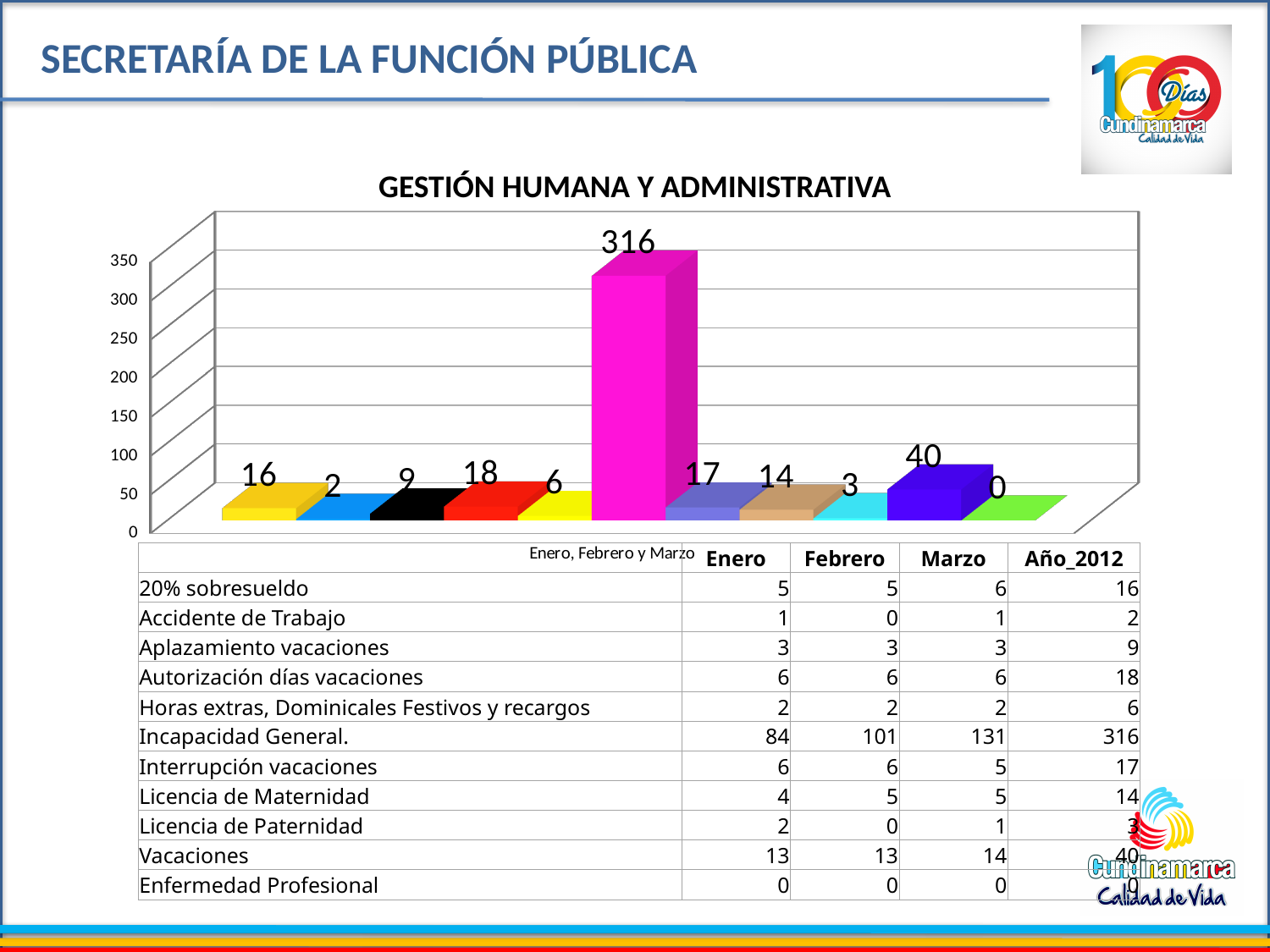
What is the title of the chart? GESTIÓN HUMANA Y ADMINISTRATIVA What is the value labelled on the bar for Vacaciones? 40 What kind of chart is shown on the slide? bar chart What is the value shown on the tallest bar in the chart? 316 Which is larger, the value for Vacaciones or the value for Interrupción vacaciones? Vacaciones Which category has the lowest value in the chart? Enfermedad Profesional What is the value labelled on the bar for Autorización días vacaciones? 18 What is the difference between the values for Incapacidad General and Vacaciones? 276 What is the value labelled on the bar for Licencia de Maternidad? 14 Is the value for Incapacidad General greater or less than 300? greater Which category has the highest value in the chart? Incapacidad General. How many bars are plotted in the chart? 11